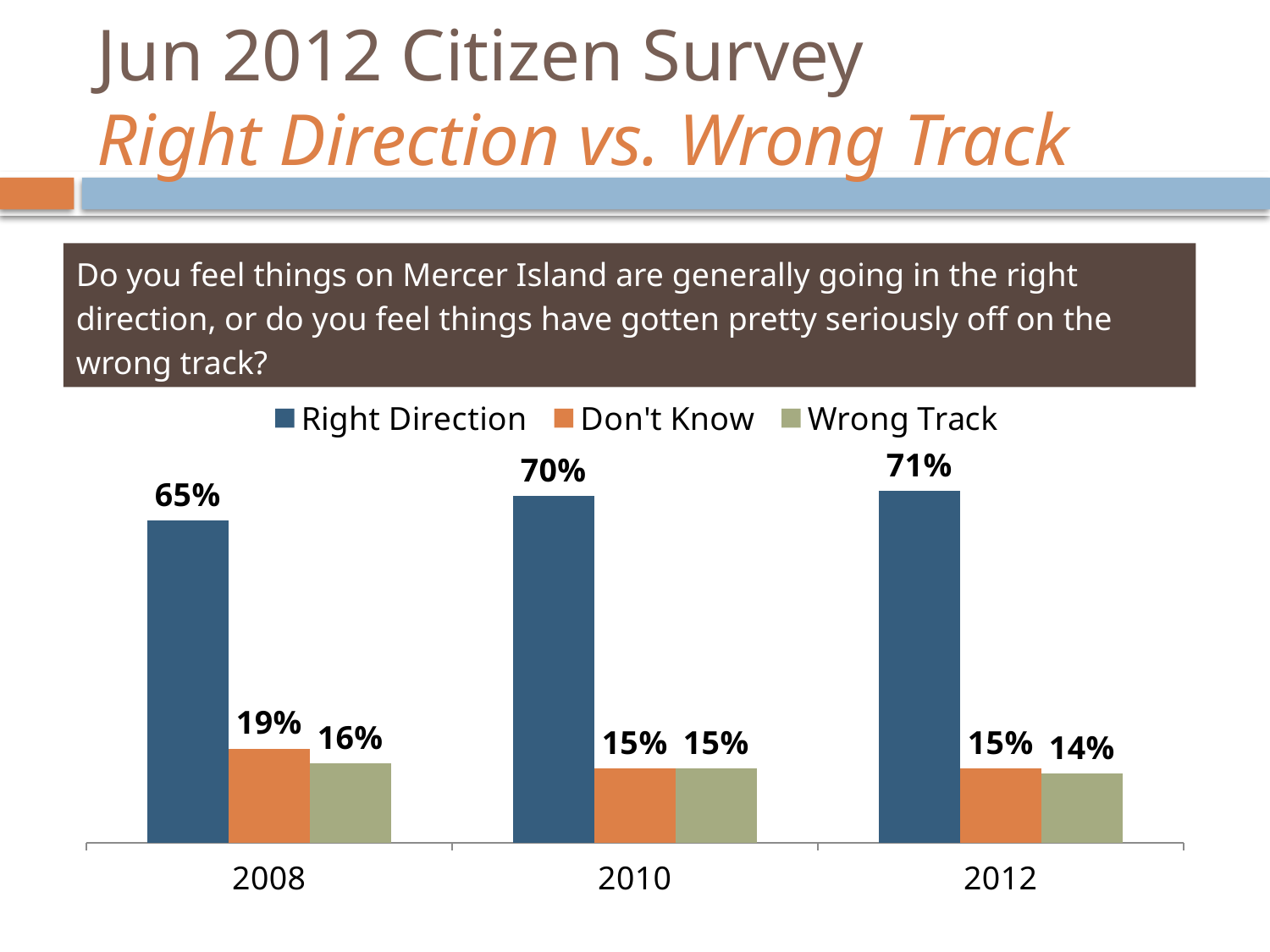
What was the "Wrong Track" value in 2010? 15% In which year was the "Right Direction" value highest? 2012 In which year was the "Wrong Track" value lowest? 2012 What percentage of respondents said "Right Direction" in 2012? 71% Which is larger in 2008: "Don't Know" or "Wrong Track"? Don't Know What colour represents the "Wrong Track" series? Green How many series does the legend list? 3 How many years are shown on the x axis? 3 What kind of chart is shown on the slide? Bar chart What was the "Don't Know" value in 2008? 19% Does the "Right Direction" value rise or fall from 2008 to 2012? Rise What is the difference between the "Right Direction" values for 2012 and 2008? 6%